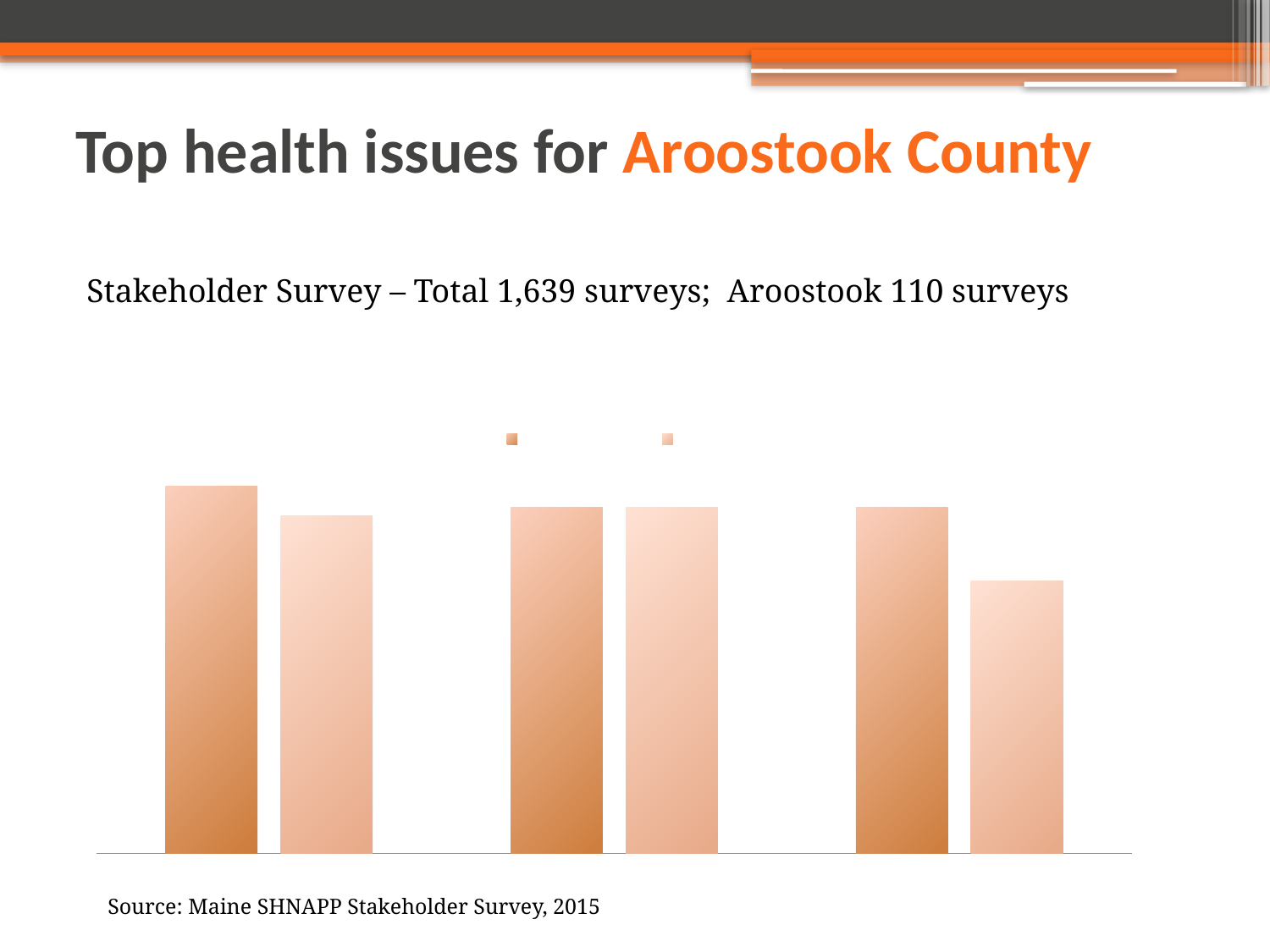
Which group of bars has its two bars closest in height: the left, middle, or right group? middle How many series does the chart's legend list? 2 What colours are used for the two series in the chart? dark orange and light orange How many groups of bars are plotted in the chart? 3 In the rightmost group of bars, which bar is taller, the darker orange one or the lighter one? the darker orange one In the leftmost group of bars, is the darker orange bar taller or shorter than the lighter bar? taller Does the chart display any data labels on the bars? No What kind of chart is shown on the slide? bar chart How many bars are plotted in the chart in total? 6